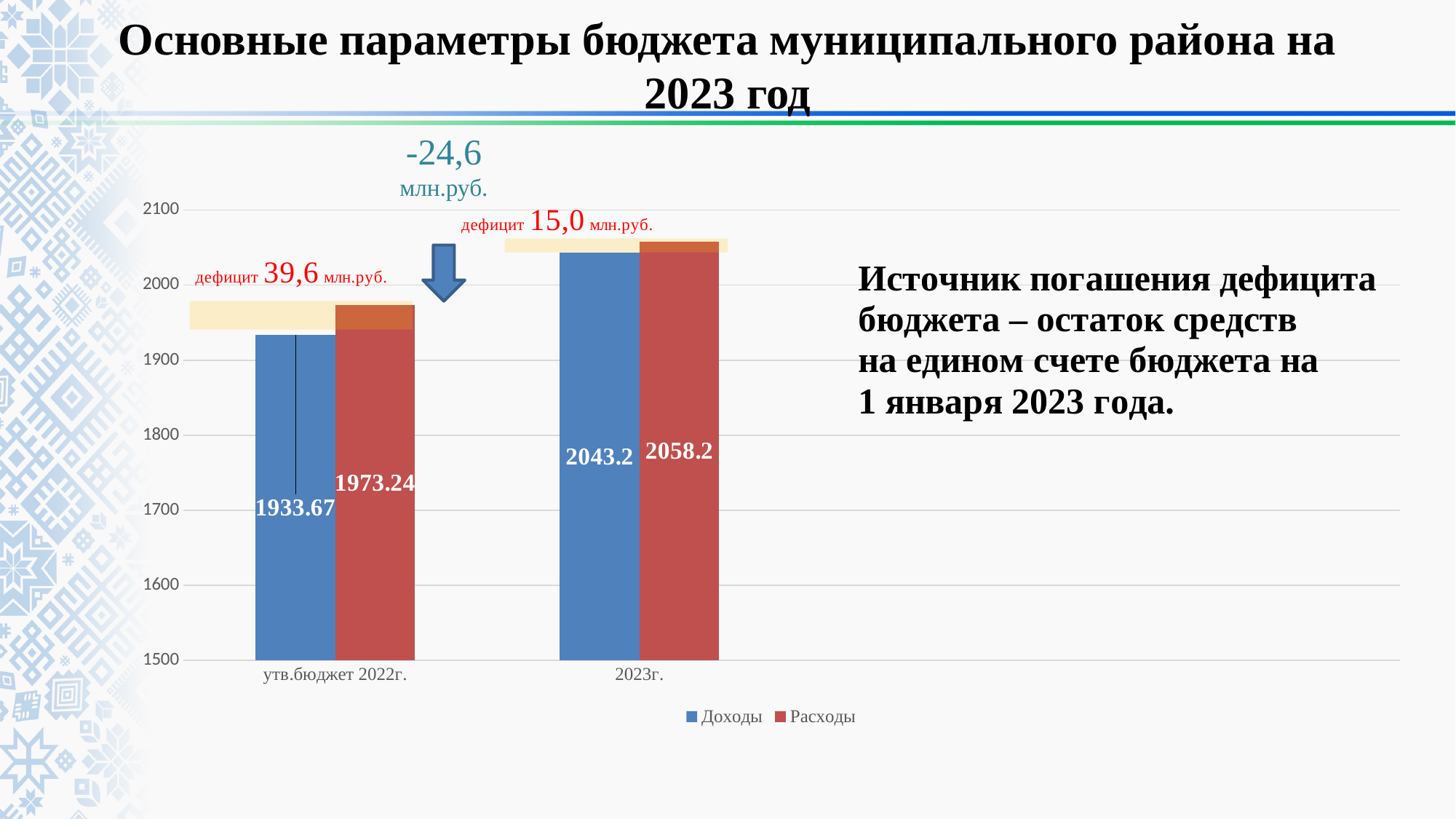
What is the value of Расходы for утв.бюджет 2022г.? 1973.24 What is the value of Доходы for утв.бюджет 2022г.? 1933.67 Is the value of Доходы for 2023г. greater or less than 2000? greater What kind of chart is shown on the slide? bar chart Which category has the highest Расходы value? 2023г. What is the difference between Расходы and Доходы for 2023г.? 15.0 How many series does the legend list? 2 What is the value of Доходы for 2023г.? 2043.2 What is the value of Расходы for 2023г.? 2058.2 Which category has the lowest Доходы value? утв.бюджет 2022г. Which is larger for утв.бюджет 2022г.: Доходы or Расходы? Расходы How many categories are shown on the x axis? 2